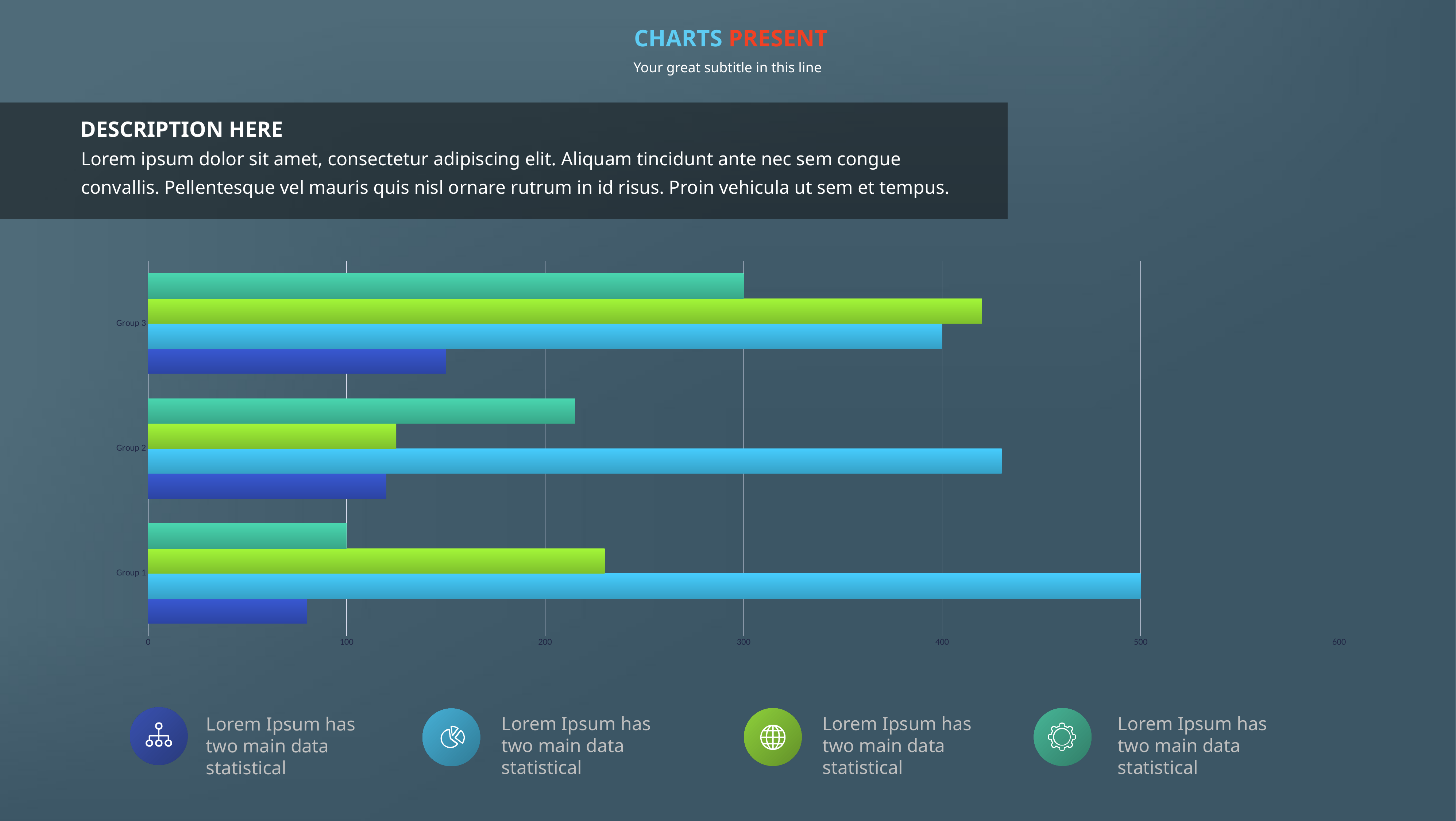
What is the difference between the light blue bar for Group 1 and the light blue bar for Group 3? 100 Within Group 1, which coloured bar is the shortest? dark blue What is the value of the teal (topmost) bar for Group 3? 300 What is the value of the light blue bar for Group 1? 500 How many groups are shown on the vertical axis of the chart? 3 Which group has the longest bar in the chart? Group 1 How many bars are plotted for each group in the chart? 4 Is the value of the light blue bar for Group 2 greater or less than 400? greater Is the value of the dark blue bar for Group 1 greater or less than 100? less What kind of chart is shown on the slide? bar chart What is the value of the teal (topmost) bar for Group 1? 100 What is the value of the light blue bar for Group 3? 400